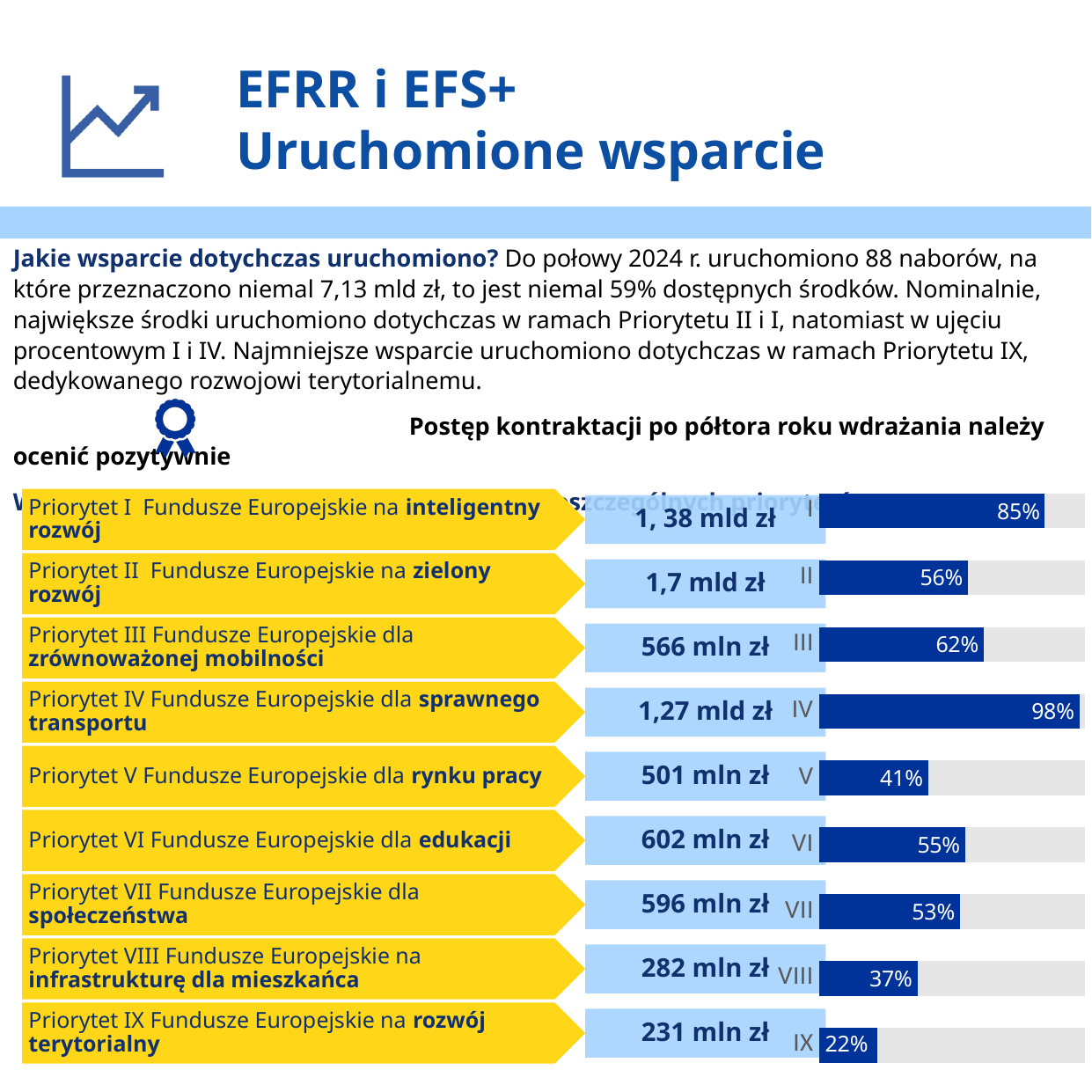
Which priority has the highest percentage in the bar chart? IV What kind of chart is used to show the percentages for the priorities? bar chart How many priorities are shown as bars in the chart? 9 What percentage is shown for Priority IX in the bar chart? 22% What is the difference in percentage points between Priority I and Priority II in the bar chart? 29 What percentage is shown for Priority IV in the bar chart? 98% Which priority has the lowest percentage in the bar chart? IX What amount is listed next to Priority VIII? 282 mln zł Which has a higher percentage in the bar chart, Priority III or Priority VII? Priority III What is the difference in percentage points between Priority V and Priority VIII in the bar chart? 4 What percentage is shown for Priority VI in the bar chart? 55% What amount is listed next to Priority II? 1,7 mld zł